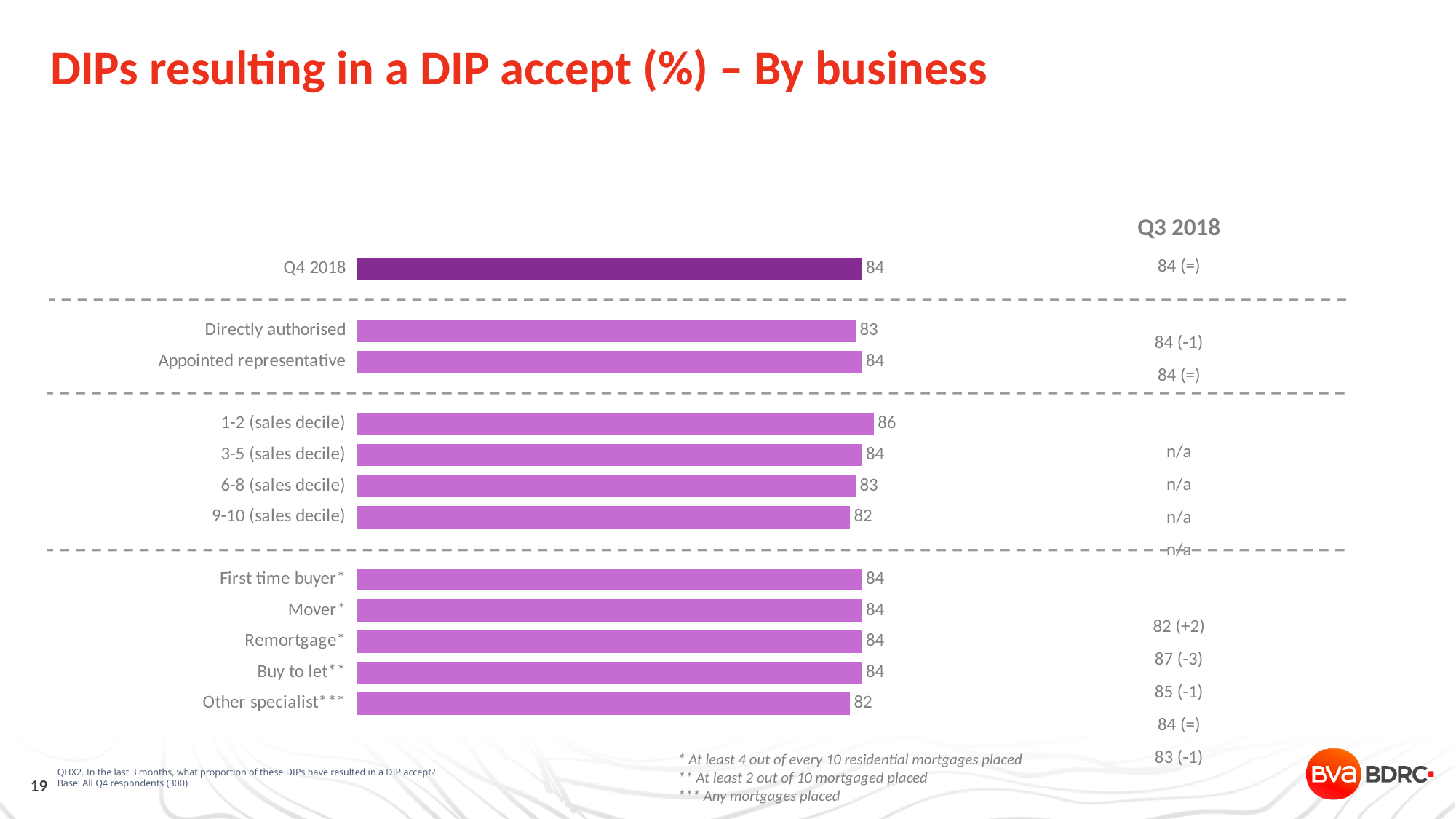
What is the difference between the values for 1-2 (sales decile) and 9-10 (sales decile)? 4 How many bars are plotted in the chart? 12 What is the value for 1-2 (sales decile)? 86 Among the sales decile groups, which has the lowest value? 9-10 (sales decile) What kind of chart is shown on the slide? Bar chart What is the difference between the values for Appointed representative and Directly authorised? 1 What is the value for Other specialist? 82 Which is larger, the value for 1-2 (sales decile) or the value for 6-8 (sales decile)? 1-2 (sales decile) What is the value for Directly authorised? 83 What is the title of the slide's chart? DIPs resulting in a DIP accept (%) – By business What is the value for Q4 2018? 84 Which category has the highest value? 1-2 (sales decile)